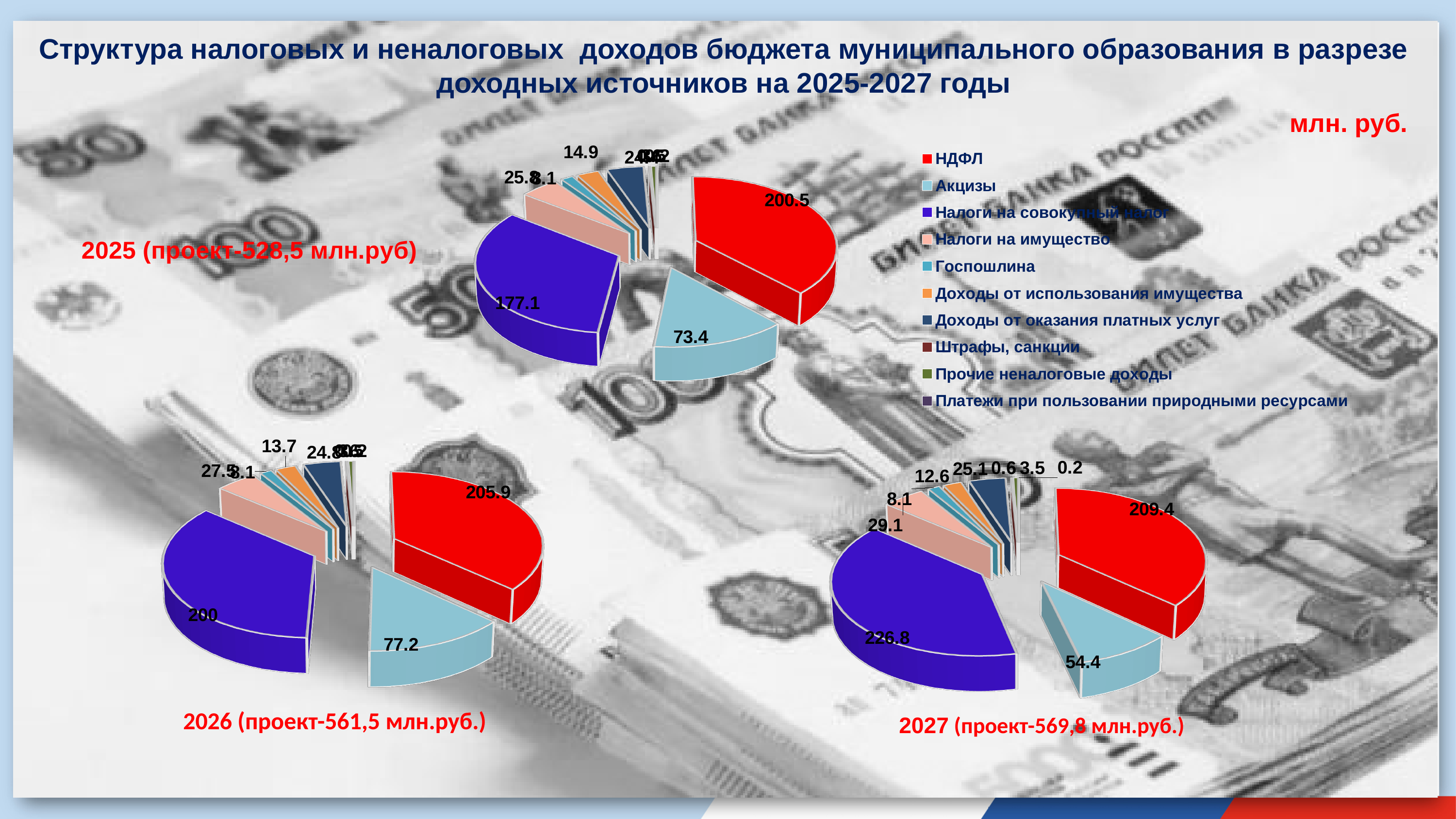
What kind of charts are shown on the slide? Pie charts On the 2027 pie chart, which category has the largest value? Налоги на совокупный налог On the 2026 pie chart, which is larger, НДФЛ or Налоги на совокупный налог? НДФЛ On the 2025 pie chart, what is the value for Налоги на совокупный налог? 177.1 On the 2025 pie chart, what is the value for Акцизы? 73.4 On the 2027 pie chart, what is the difference between НДФЛ and Акцизы? 155 On the 2025 pie chart, which category has the largest value? НДФЛ On the 2026 pie chart, what is the value for Акцизы? 77.2 How many entries does the legend list? 10 On the 2027 pie chart, what is the value for Налоги на имущество? 29.1 On the 2027 pie chart, what is the value for Налоги на совокупный налог? 226.8 On the 2025 pie chart, what is the value for НДФЛ? 200.5